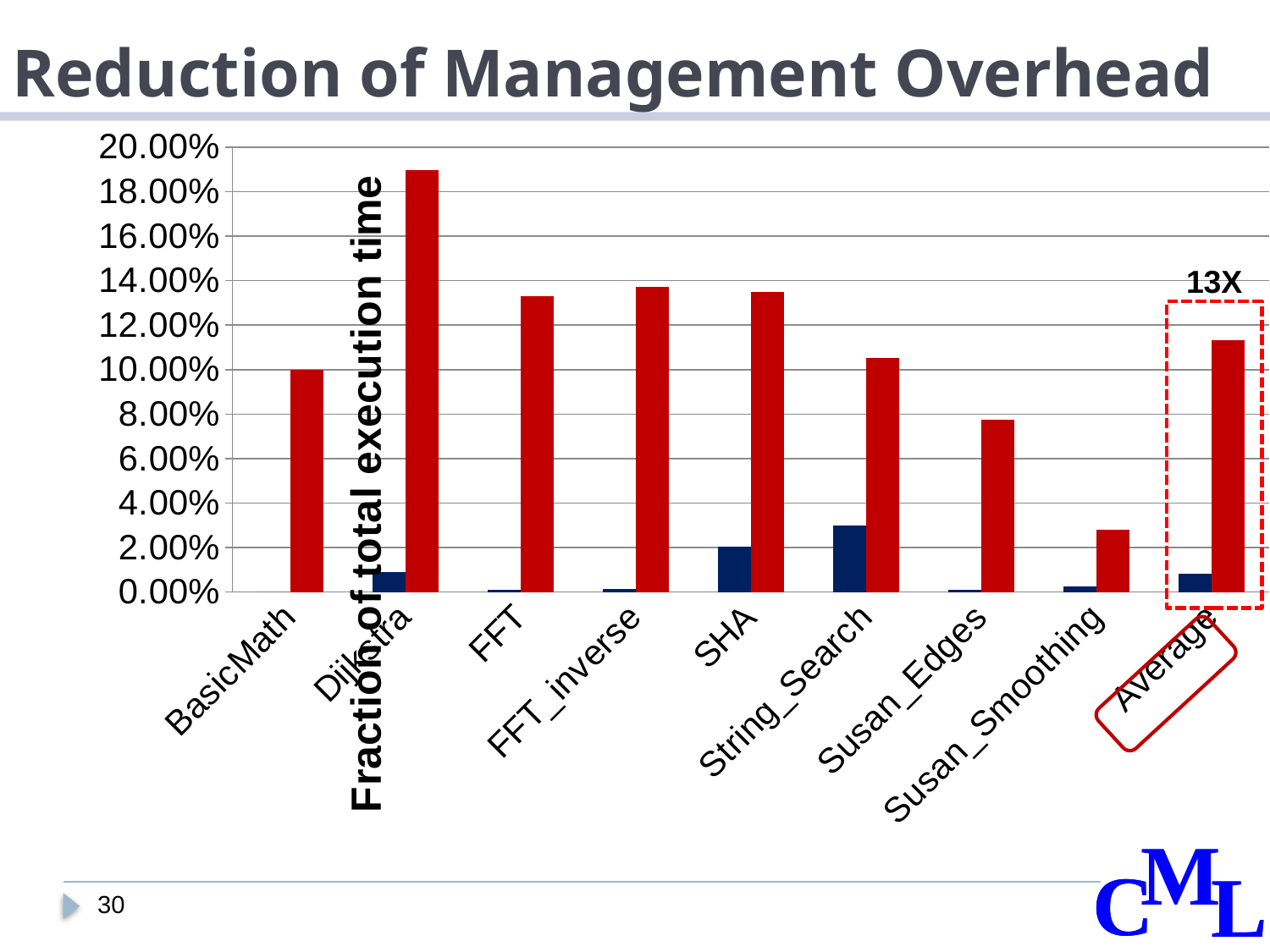
Which category has the tallest red bar? Dijkstra Which category has the shortest red bar? Susan_Smoothing Which category has the tallest blue bar? String_Search Which has the larger blue bar, SHA or String_Search? String_Search Is the red bar for Dijkstra greater or less than 18.00%? greater Is the red bar for Average greater or less than 10.00%? greater How many categories are shown along the x axis? 9 Is the red bar for Susan_Edges greater or less than 6.00%? greater What kind of chart is shown on the slide? bar chart What is the label on the vertical axis of the chart? Fraction of total execution time Which has the larger red bar, FFT or Dijkstra? Dijkstra